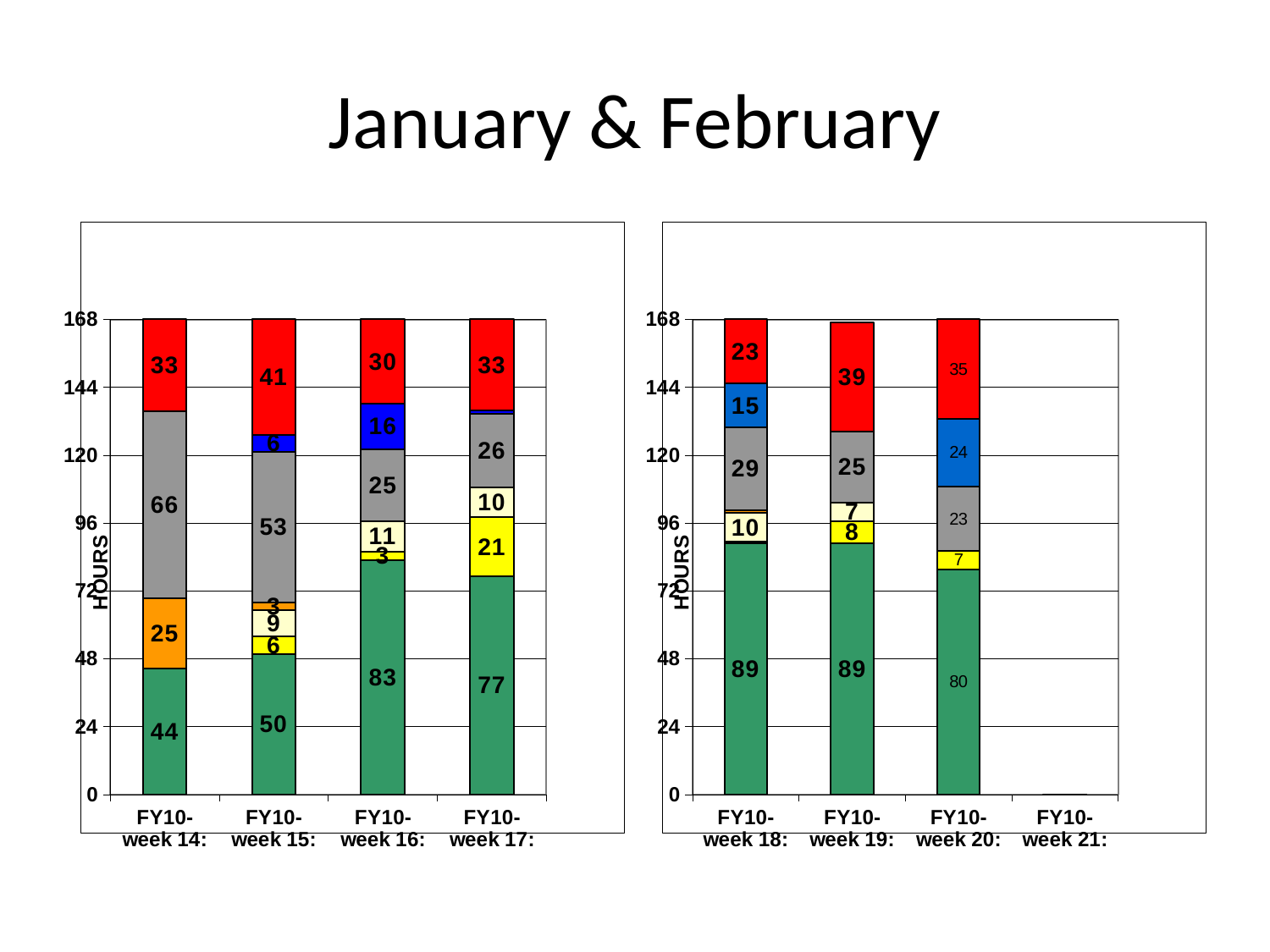
What kind of chart is shown on the left of the slide? Stacked bar chart In the right chart, what is the value of the gray segment for FY10-week 18? 29 In the right chart, is the green segment larger for FY10-week 18 or FY10-week 20? FY10-week 18 In the left chart, what is the difference between the gray segments for FY10-week 14 and FY10-week 15? 13 In the left chart, which week has the largest green segment? FY10-week 16 In the right chart, what is the value of the blue segment for FY10-week 20? 24 In the left chart, what is the value of the green segment for FY10-week 14? 44 What is the label on the vertical axis of the right chart? HOURS In the left chart, what is the value of the red segment for FY10-week 15? 41 In the right chart, which week has the largest red segment? FY10-week 19 In the left chart, what is the total of the stacked bar for FY10-week 14? 168 In the left chart, which week has the smallest green segment? FY10-week 14